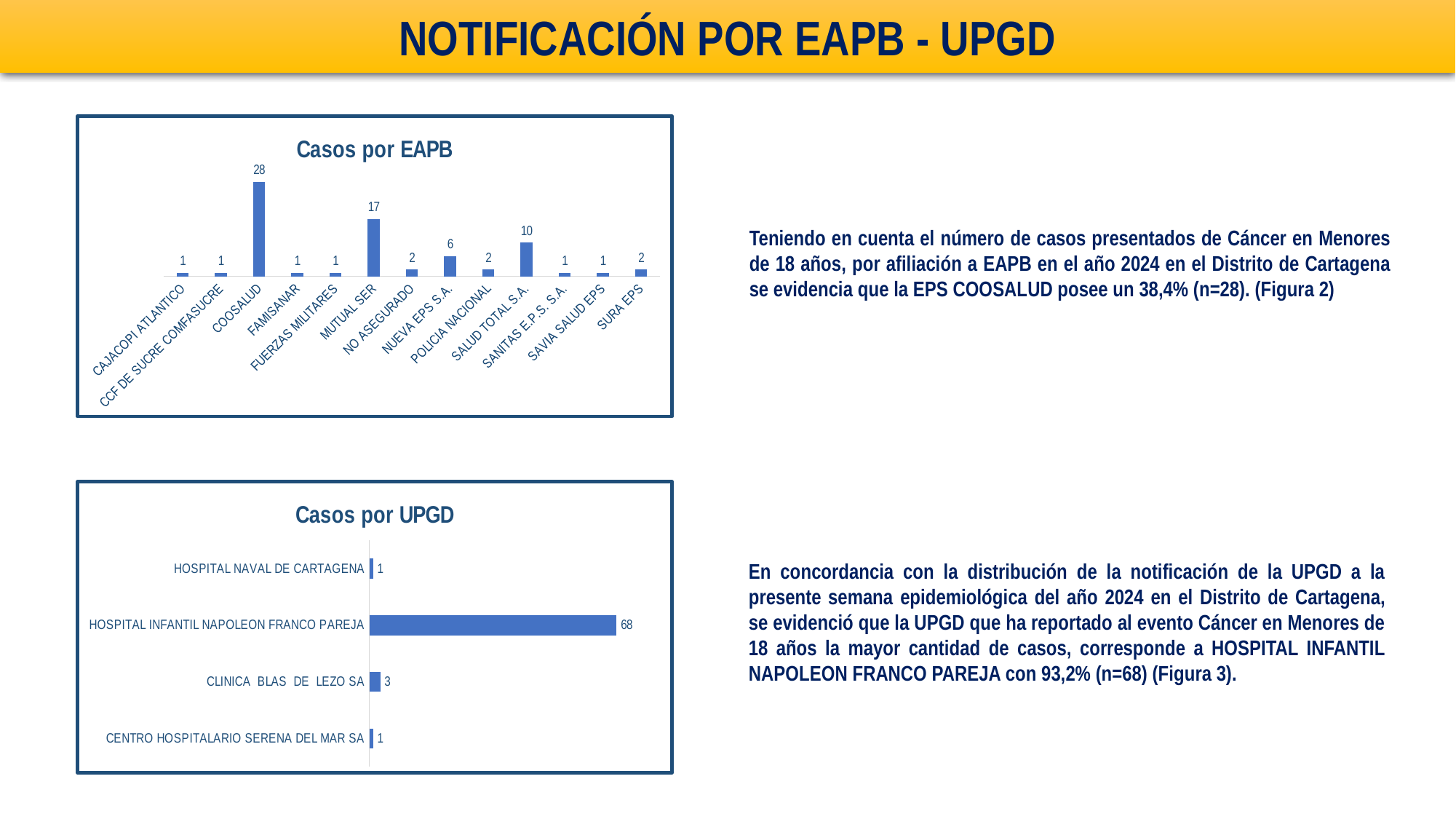
In the 'Casos por EAPB' chart, what is the difference between COOSALUD and MUTUAL SER? 11 What kind of chart is 'Casos por UPGD'? Bar chart How many categories are shown in the 'Casos por EAPB' chart? 13 In the 'Casos por EAPB' chart, which is larger, NUEVA EPS S.A. or POLICIA NACIONAL? NUEVA EPS S.A. In the 'Casos por EAPB' chart, what is the value for SALUD TOTAL S.A.? 10 How many categories are shown in the 'Casos por UPGD' chart? 4 In the 'Casos por EAPB' chart, what is the value for COOSALUD? 28 In the 'Casos por EAPB' chart, what is the value for MUTUAL SER? 17 In the 'Casos por UPGD' chart, what is the value for HOSPITAL INFANTIL NAPOLEON FRANCO PAREJA? 68 In the 'Casos por UPGD' chart, what is the value for CLINICA BLAS DE LEZO SA? 3 In the 'Casos por UPGD' chart, what is the difference between HOSPITAL INFANTIL NAPOLEON FRANCO PAREJA and CLINICA BLAS DE LEZO SA? 65 In the 'Casos por EAPB' chart, which category has the highest value? COOSALUD